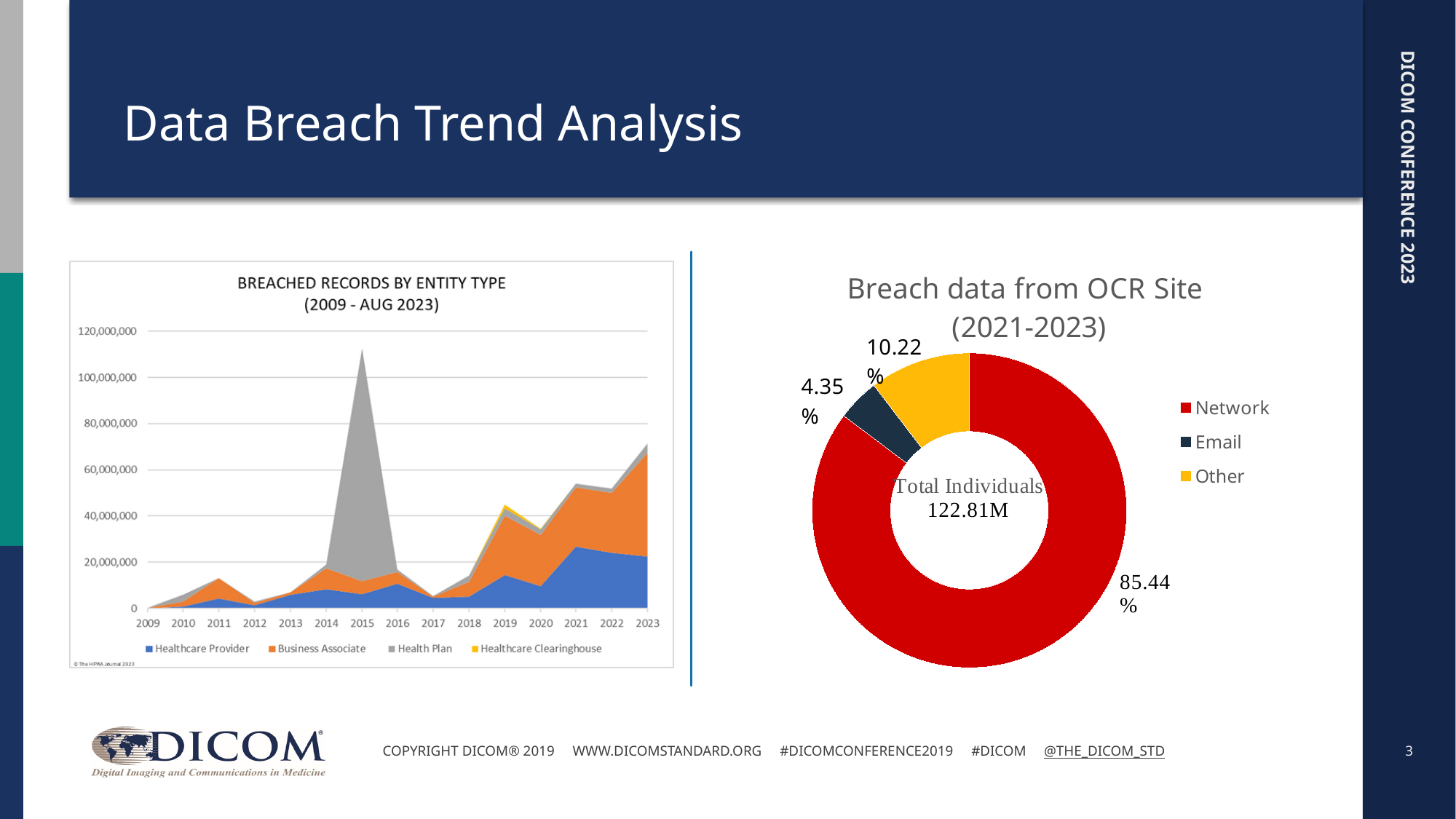
In the 'Breach data from OCR Site (2021-2023)' chart, which category has the smallest share? Email In the 'Breach data from OCR Site (2021-2023)' chart, what share of the doughnut is Network? 85.44% How many series does the legend of the 'BREACHED RECORDS BY ENTITY TYPE (2009 - AUG 2023)' chart list? 4 In the 'BREACHED RECORDS BY ENTITY TYPE (2009 - AUG 2023)' chart, in which year does the total of breached records reach its highest peak? 2015 In the 'Breach data from OCR Site (2021-2023)' chart, which category has the largest share? Network In the 'BREACHED RECORDS BY ENTITY TYPE (2009 - AUG 2023)' chart, is the total value for 2015 greater or less than 100,000,000? greater In the 'Breach data from OCR Site (2021-2023)' chart, what total number of individuals is shown in the centre of the doughnut? 122.81M In the 'Breach data from OCR Site (2021-2023)' chart, what is the difference in percentage points between the Other share and the Email share? 5.87 What kind of chart is 'BREACHED RECORDS BY ENTITY TYPE (2009 - AUG 2023)' on the left of the slide? Stacked area chart How many categories does the legend of the 'Breach data from OCR Site (2021-2023)' chart list? 3 In the 'Breach data from OCR Site (2021-2023)' chart, what share of the doughnut is Other? 10.22% In the 'Breach data from OCR Site (2021-2023)' chart, what share of the doughnut is Email? 4.35%